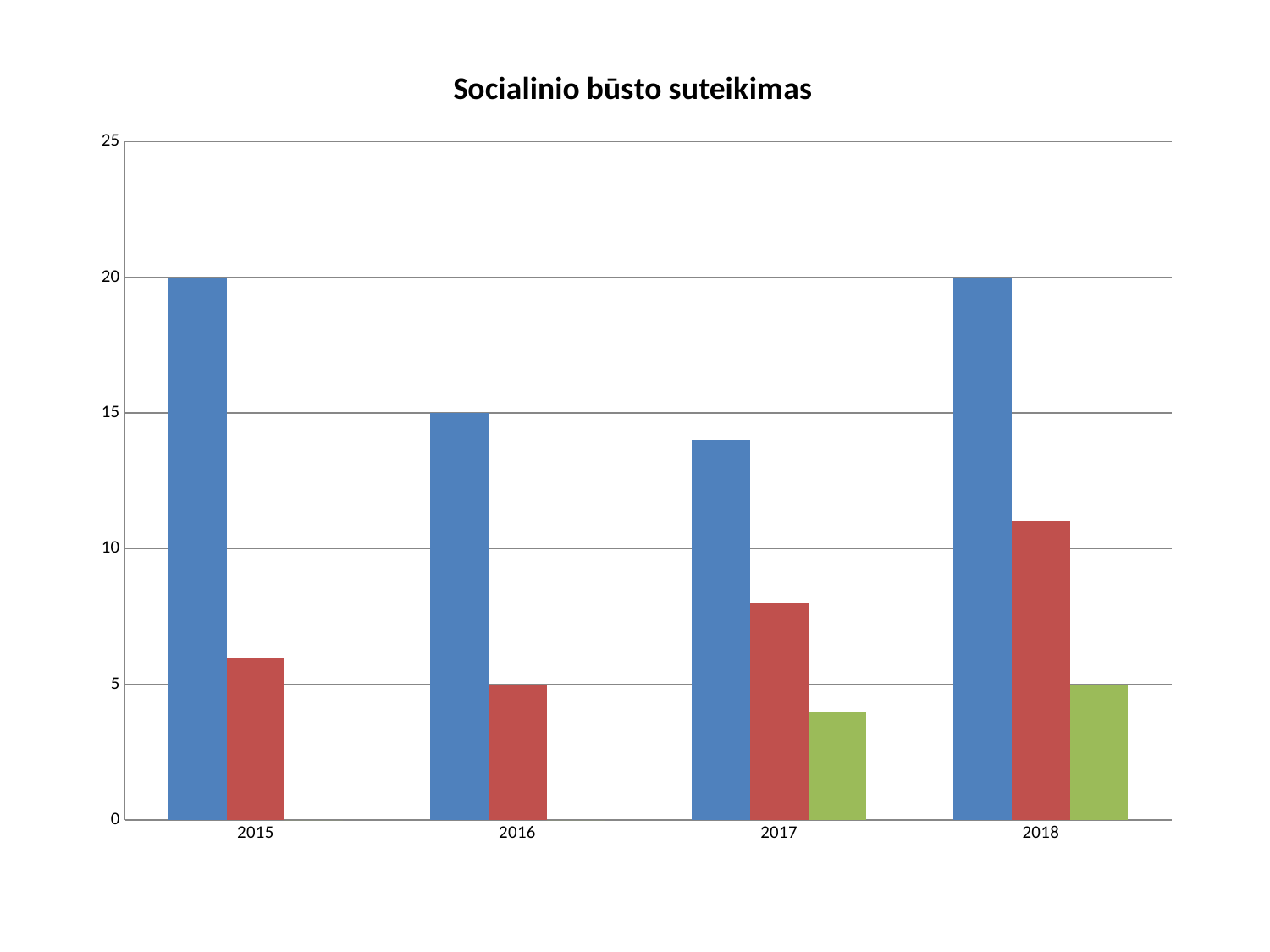
Which year has the highest red bar? 2018 What is the value of the blue bar for 2015? 20 Is the value of the blue bar for 2017 greater or less than 10? greater What is the title of the chart? Socialinio būsto suteikimas What kind of chart is shown on the slide? bar chart What is the value of the green bar for 2018? 5 What is the difference between the blue bar for 2015 and the blue bar for 2016? 5 Is the value of the red bar for 2015 greater or less than 10? less What is the value of the blue bar for 2016? 15 How many years are shown on the x axis of the chart? 4 What is the value of the red bar for 2016? 5 In 2017, which bar is taller, the blue bar or the red bar? the blue bar